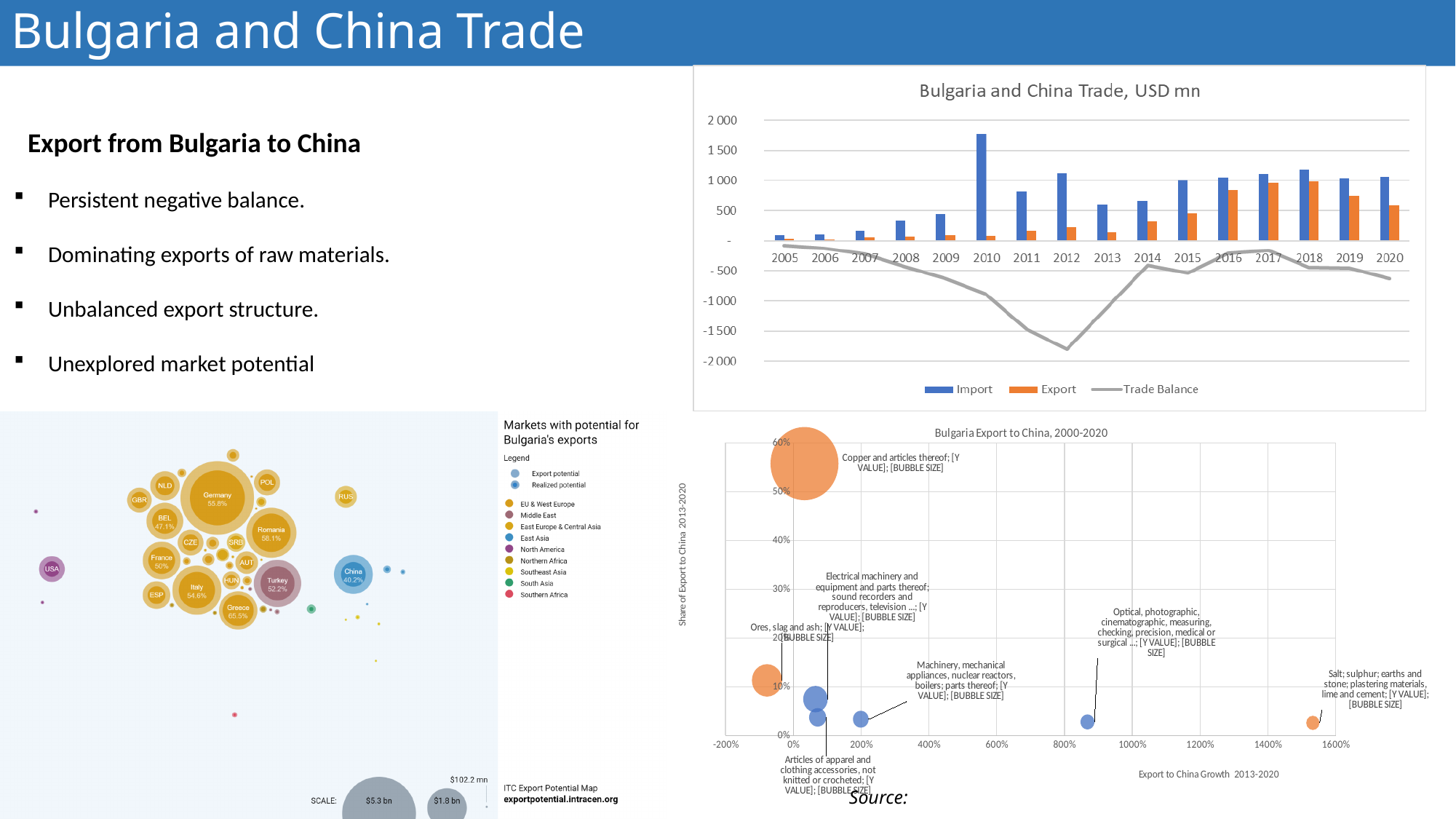
In the chart titled 'Bulgaria Export to China, 2000-2020', is the share of export for Copper and articles thereof greater or less than 50%? greater In the chart titled 'Bulgaria and China Trade, USD mn', in which year is the Trade Balance lowest? 2012 In the chart titled 'Bulgaria Export to China, 2000-2020', which product has the highest share of export to China? Copper and articles thereof In the chart titled 'Bulgaria and China Trade, USD mn', what kind of chart is used for Import and Export? Bar chart In the chart titled 'Bulgaria and China Trade, USD mn', how many years are shown on the x axis? 16 In the chart titled 'Bulgaria and China Trade, USD mn', which is larger in 2015, Import or Export? Import In the chart titled 'Bulgaria and China Trade, USD mn', how many series does the legend list? 3 In the chart titled 'Bulgaria and China Trade, USD mn', is the Export value for 2016 greater or less than 500? greater In the 'Markets with potential for Bulgaria's exports' map at the bottom left, what percentage is shown for Germany? 55.8% In the chart titled 'Bulgaria and China Trade, USD mn', is the Import value for 2010 greater or less than 1 500? greater In the chart titled 'Bulgaria and China Trade, USD mn', in which year is Import highest? 2010